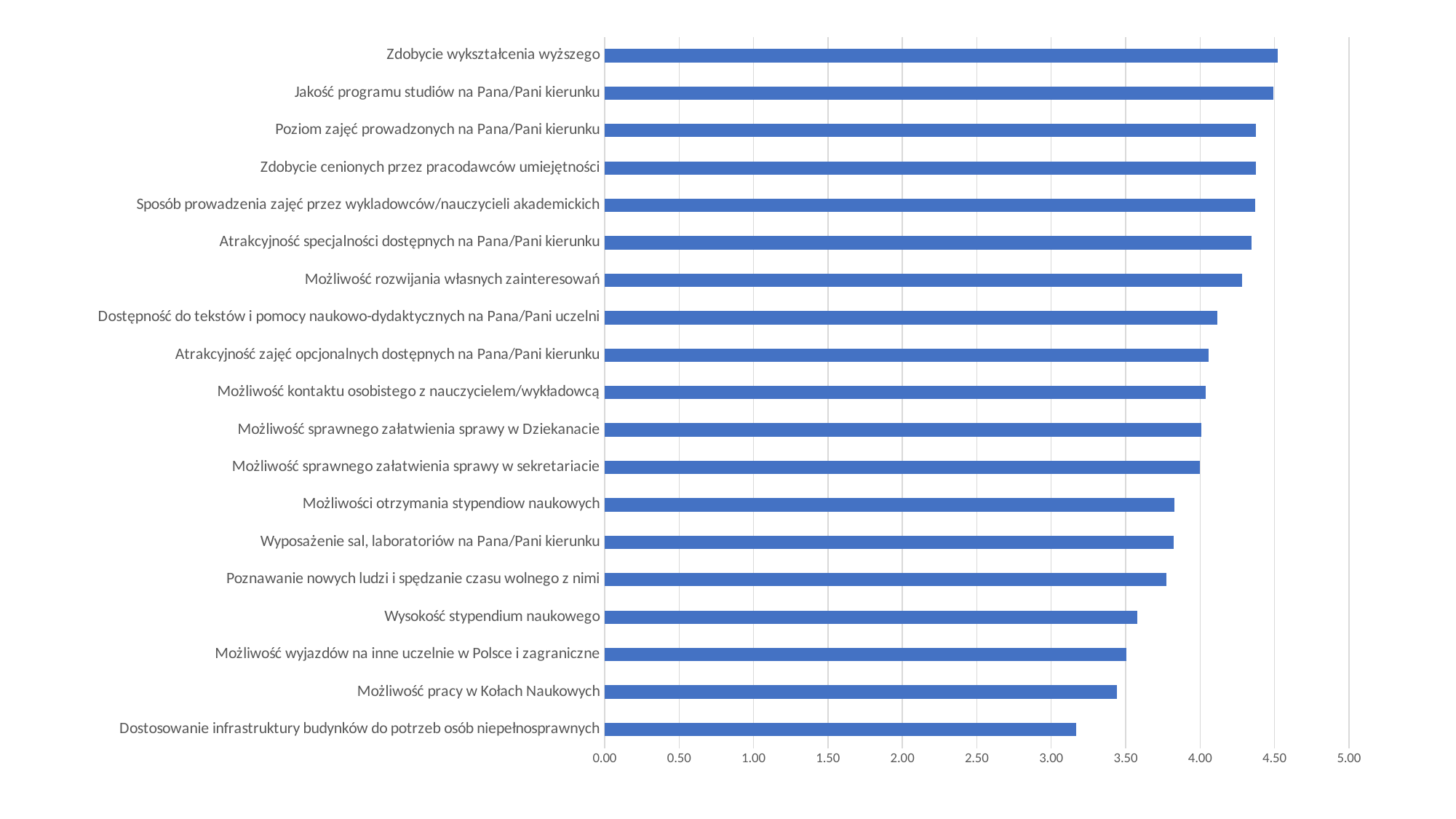
How many categories are plotted in the chart? 19 Is the value for Wysokość stypendium naukowego greater or less than 3.50? greater Is the value for Możliwości otrzymania stypendiow naukowych greater or less than 4.00? less Which category has the lowest value in the chart? Dostosowanie infrastruktury budynków do potrzeb osób niepełnosprawnych What is the maximum value shown on the horizontal axis? 5.00 Is the value for Poznawanie nowych ludzi i spędzanie czasu wolnego z nimi greater or less than 4.00? less What kind of chart is shown on the slide? bar chart Which has the larger value: Możliwość rozwijania własnych zainteresowań or Wysokość stypendium naukowego? Możliwość rozwijania własnych zainteresowań Which has the larger value: Zdobycie wykształcenia wyższego or Dostosowanie infrastruktury budynków do potrzeb osób niepełnosprawnych? Zdobycie wykształcenia wyższego